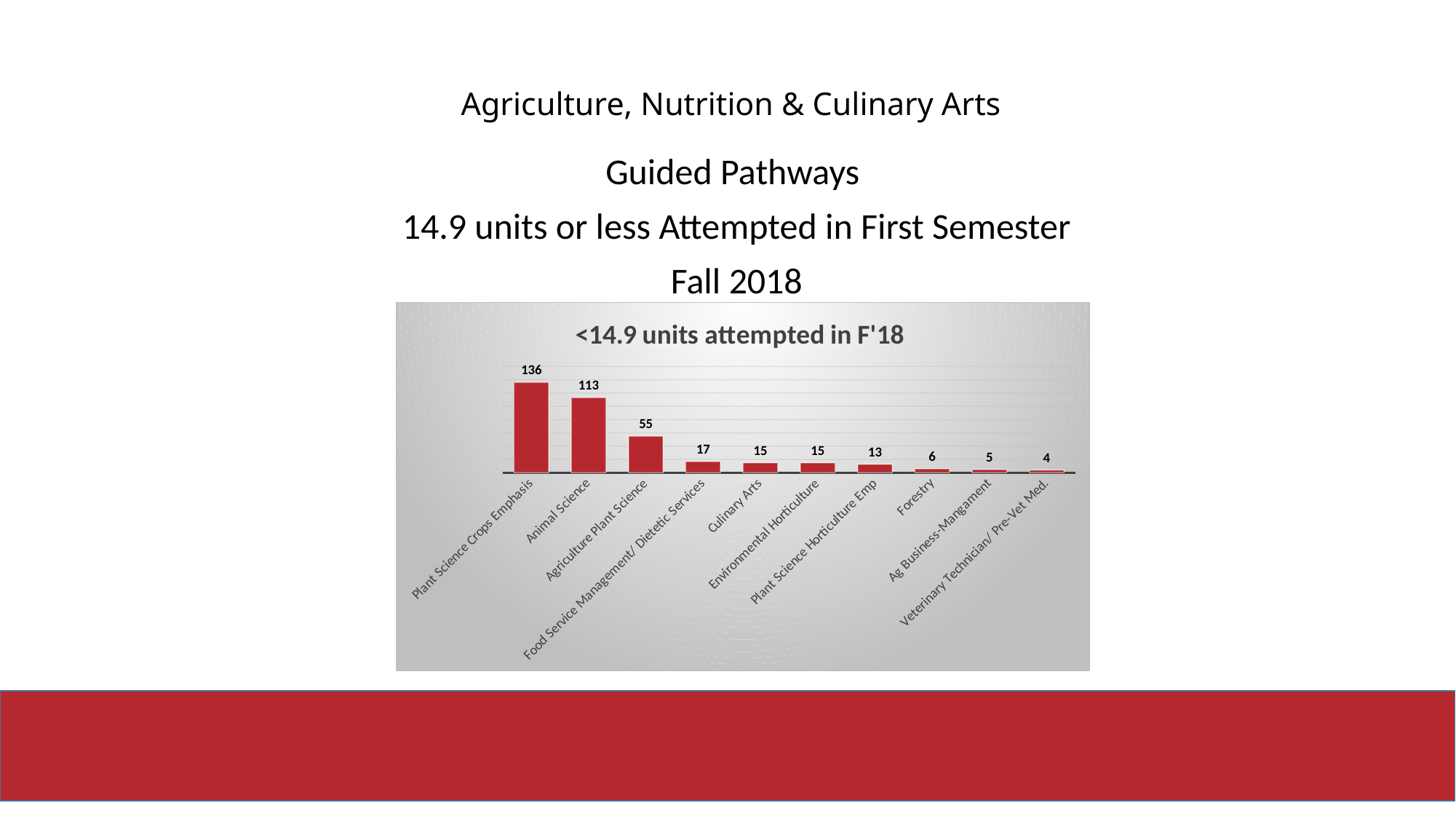
Do the values rise or fall from left to right along the x axis? Fall What is the value for Plant Science Crops Emphasis? 136 What is the title of the chart? <14.9 units attempted in F'18 What is the value for Forestry? 6 How many categories are shown in the chart? 10 Which category has the lowest value? Veterinary Technician/ Pre-Vet Med. Which category has the highest value? Plant Science Crops Emphasis Which is larger, the value for Food Service Management/ Dietetic Services or the value for Plant Science Horticulture Emp? Food Service Management/ Dietetic Services What is the value for Animal Science? 113 What is the value for Agriculture Plant Science? 55 What is the difference between the values for Plant Science Crops Emphasis and Animal Science? 23 What kind of chart is shown on the slide? Bar chart